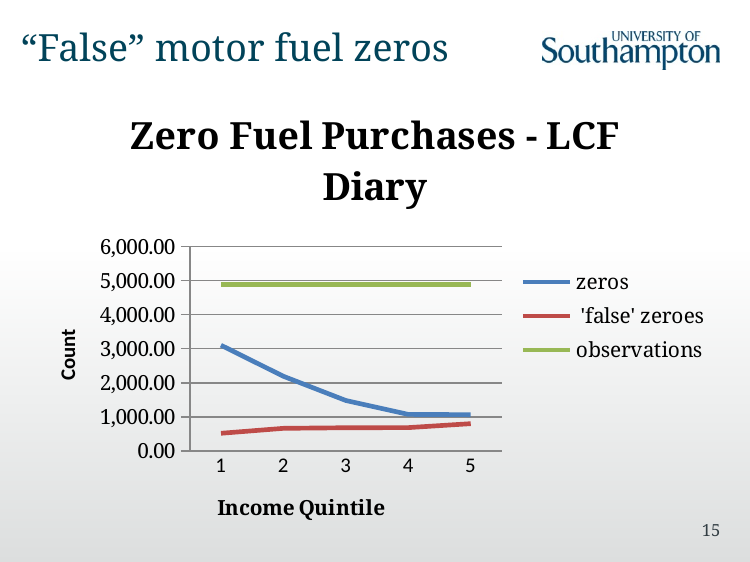
How many income quintiles are plotted on the x axis? 5 Do the values for zeros rise or fall as income quintile increases from 1 to 5? fall Is the value for 'false' zeroes at income quintile 1 greater or less than 1,000.00? less What kind of chart is shown on the slide? line chart How many series does the legend list? 3 Which series has the highest value at income quintile 5? observations What is the title of the chart? Zero Fuel Purchases - LCF Diary Is the value for zeros at income quintile 5 greater or less than 2,000.00? less At income quintile 1, which is larger: zeros or 'false' zeroes? zeros Is the value for zeros at income quintile 1 greater or less than 2,000.00? greater What is the label of the y axis? Count